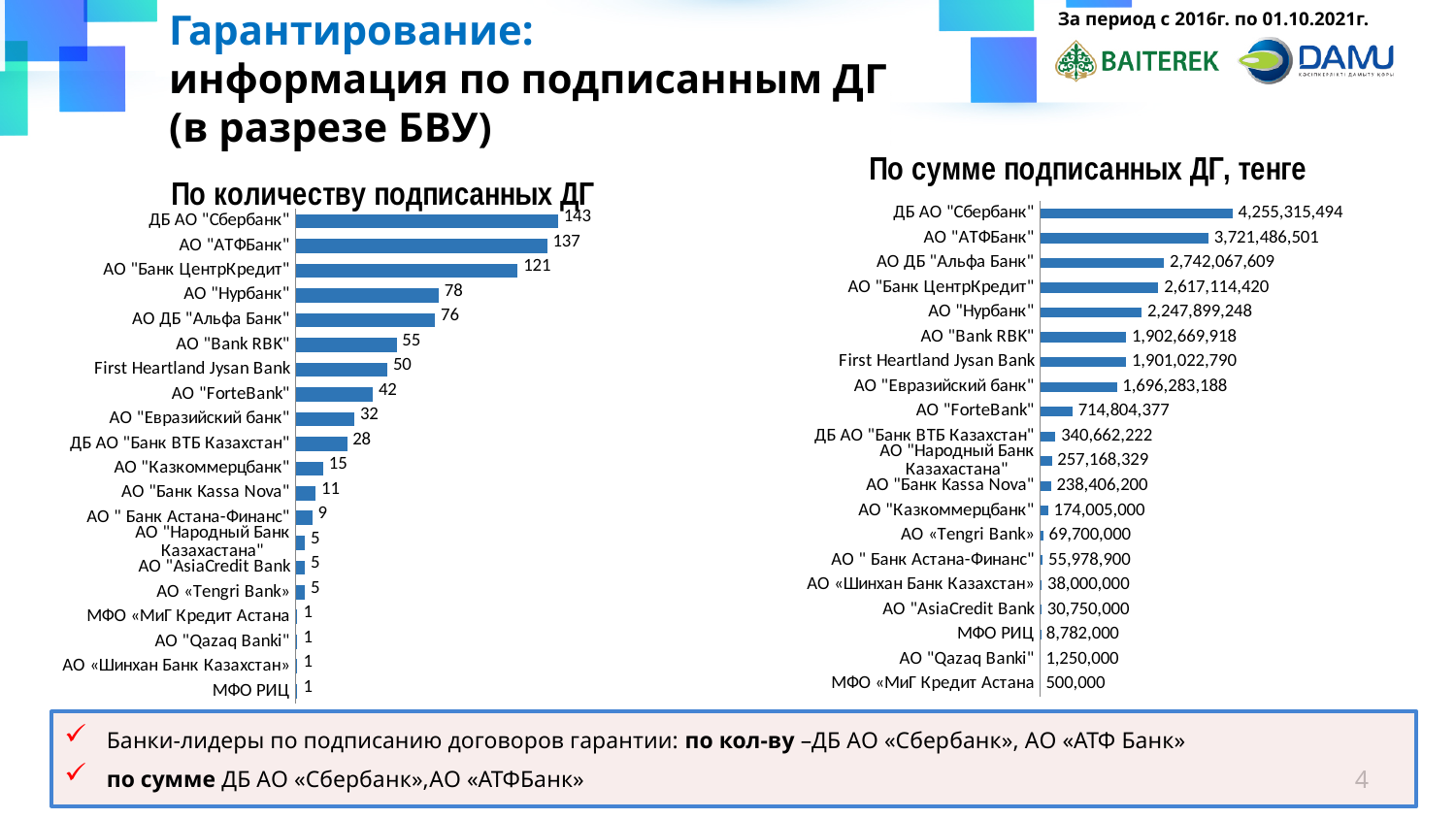
On the chart "По сумме подписанных ДГ, тенге", what is the value for АО ДБ "Альфа Банк"? 2,742,067,609 On the chart "По количеству подписанных ДГ", what is the difference between ДБ АО "Сбербанк" and АО "АТФБанк"? 6 On the chart "По сумме подписанных ДГ, тенге", what is the value for АО "ForteBank"? 714,804,377 On the chart "По сумме подписанных ДГ, тенге", what is the difference between ДБ АО "Сбербанк" and АО "АТФБанк"? 533,828,993 What type of chart is "По сумме подписанных ДГ, тенге"? Bar chart On the chart "По количеству подписанных ДГ", which is larger: АО "Bank RBK" or First Heartland Jysan Bank? АО "Bank RBK" On the chart "По количеству подписанных ДГ", what is the value for АО "Нурбанк"? 78 On the chart "По сумме подписанных ДГ, тенге", which bank has the lowest value? МФО «МиГ Кредит Астана On the chart "По сумме подписанных ДГ, тенге", which is larger: АО "Банк ЦентрКредит" or АО "Нурбанк"? АО "Банк ЦентрКредит" On the chart "По количеству подписанных ДГ", how many categories are plotted? 20 On the chart "По количеству подписанных ДГ", which bank has the highest value? ДБ АО "Сбербанк" On the chart "По количеству подписанных ДГ", what is the value for АО "Банк Kassa Nova"? 11